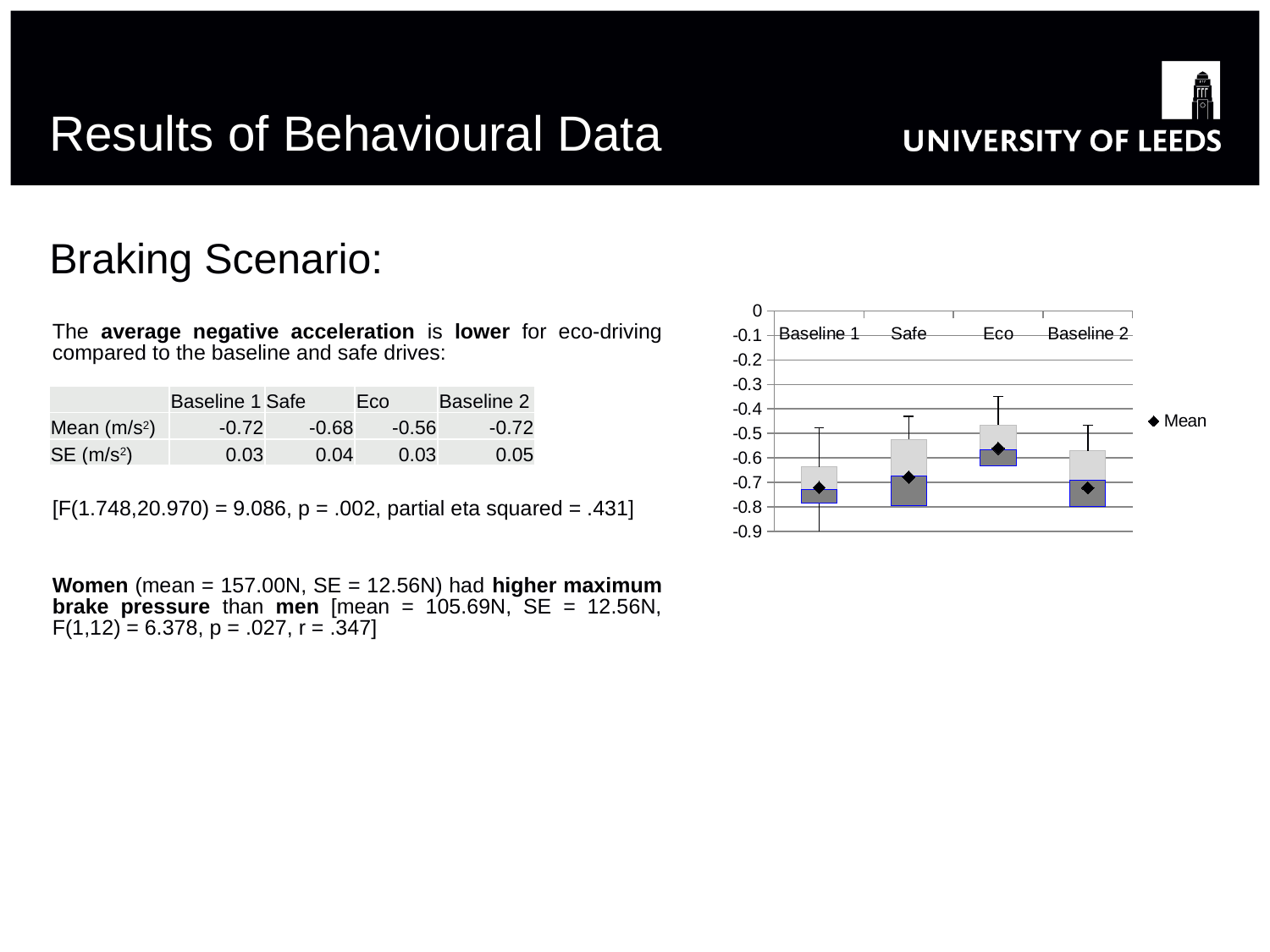
What is the lowest value labelled on the chart's y axis? -0.9 Which category has the highest (least negative) mean marker on the chart? Eco What is the mean value (m/s²) for Eco shown on the slide? -0.56 What is the mean value (m/s²) for Safe shown on the slide? -0.68 Is the mean marker for Baseline 2 greater or less than -0.7? less How many categories are shown on the x axis of the chart? 4 How many series does the chart legend list? 1 Is the mean marker for Eco greater or less than -0.6? greater Is the mean marker for Baseline 1 greater or less than -0.7? less What is the difference between the mean values for Eco and Safe shown on the slide? 0.12 Which has the higher mean marker on the chart, Eco or Safe? Eco What is the only entry in the chart legend? Mean